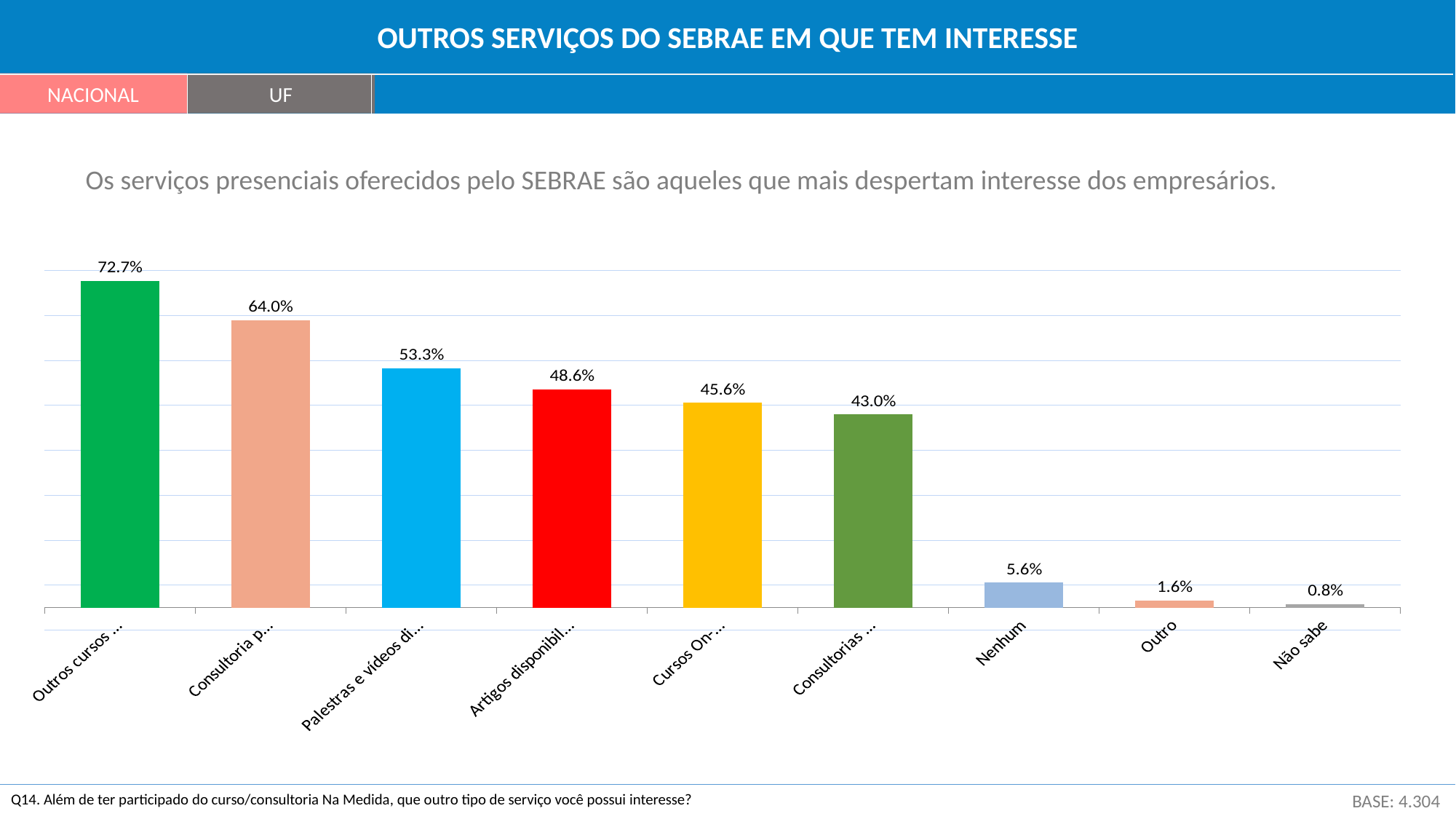
What is the value for Outro? 1.6% What kind of chart is shown on the slide? Bar chart How many categories are shown in the chart? 9 What is the difference between the values for Nenhum and Outro? 4.0 percentage points What is the value of the tallest bar in the chart? 72.7% Which is larger, the value for Nenhum or the value for Outro? Nenhum What is the difference between the values for Outro and Não sabe? 0.8 percentage points Do the values rise or fall from left to right along the x axis? Fall What is the title of the slide? OUTROS SERVIÇOS DO SEBRAE EM QUE TEM INTERESSE What is the value for Nenhum? 5.6% Which category has the lowest value? Não sabe What is the value for Não sabe? 0.8%